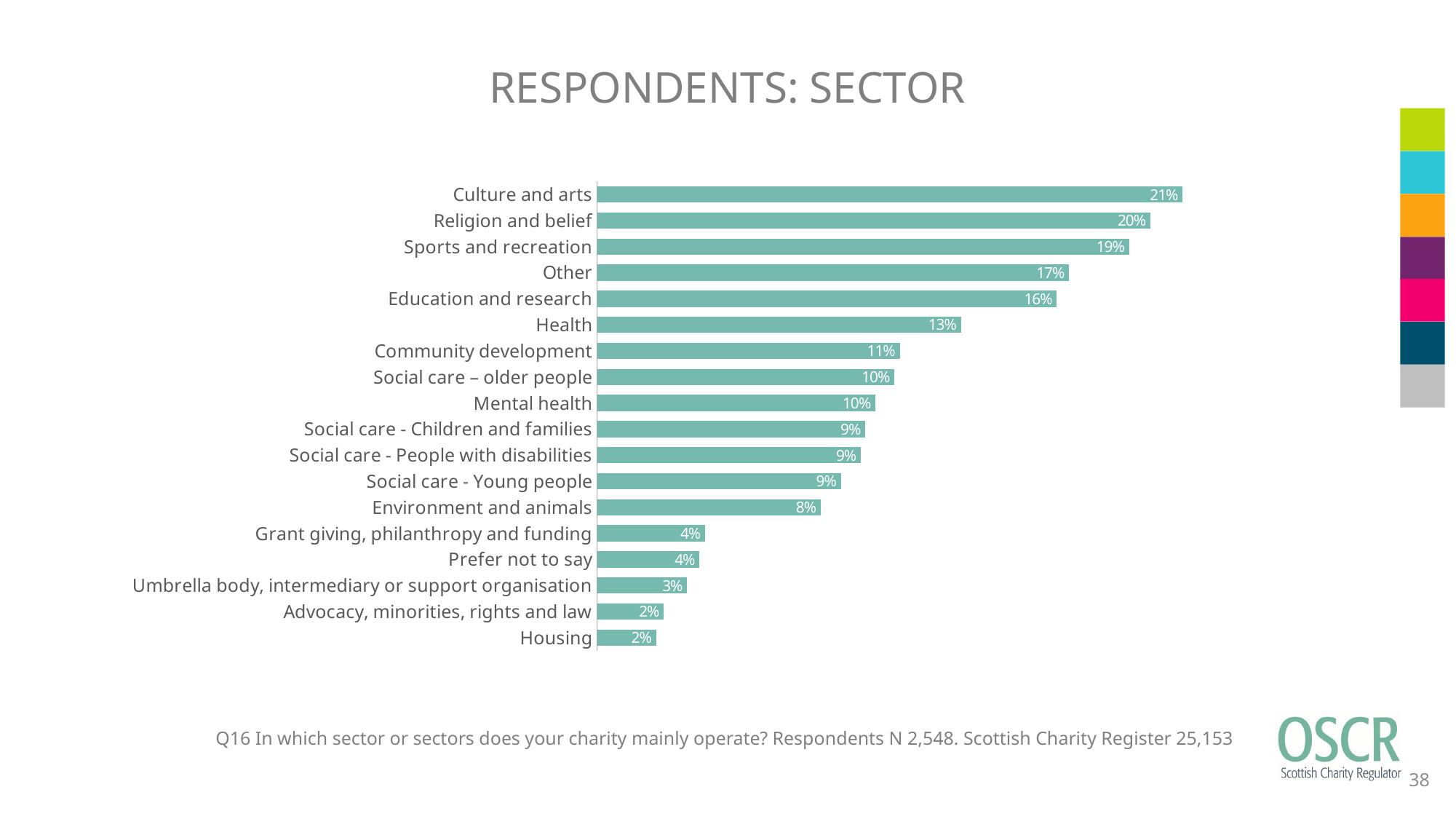
What is the difference between the values for Education and research and Grant giving, philanthropy and funding? 12% Which is larger, the value for Mental health or the value for Environment and animals? Mental health What is the difference between the values for Religion and belief and Community development? 9% What percentage of respondents operate in the Culture and arts sector? 21% What is the value shown for Health? 13% Which is larger, the value for Sports and recreation or the value for Other? Sports and recreation What is the title of the slide? RESPONDENTS: SECTOR What is the value shown for Environment and animals? 8% What is the value shown for Umbrella body, intermediary or support organisation? 3% How many sector categories are shown in the chart? 18 What type of chart is shown on the slide? Bar chart Which sector has the highest percentage of respondents? Culture and arts